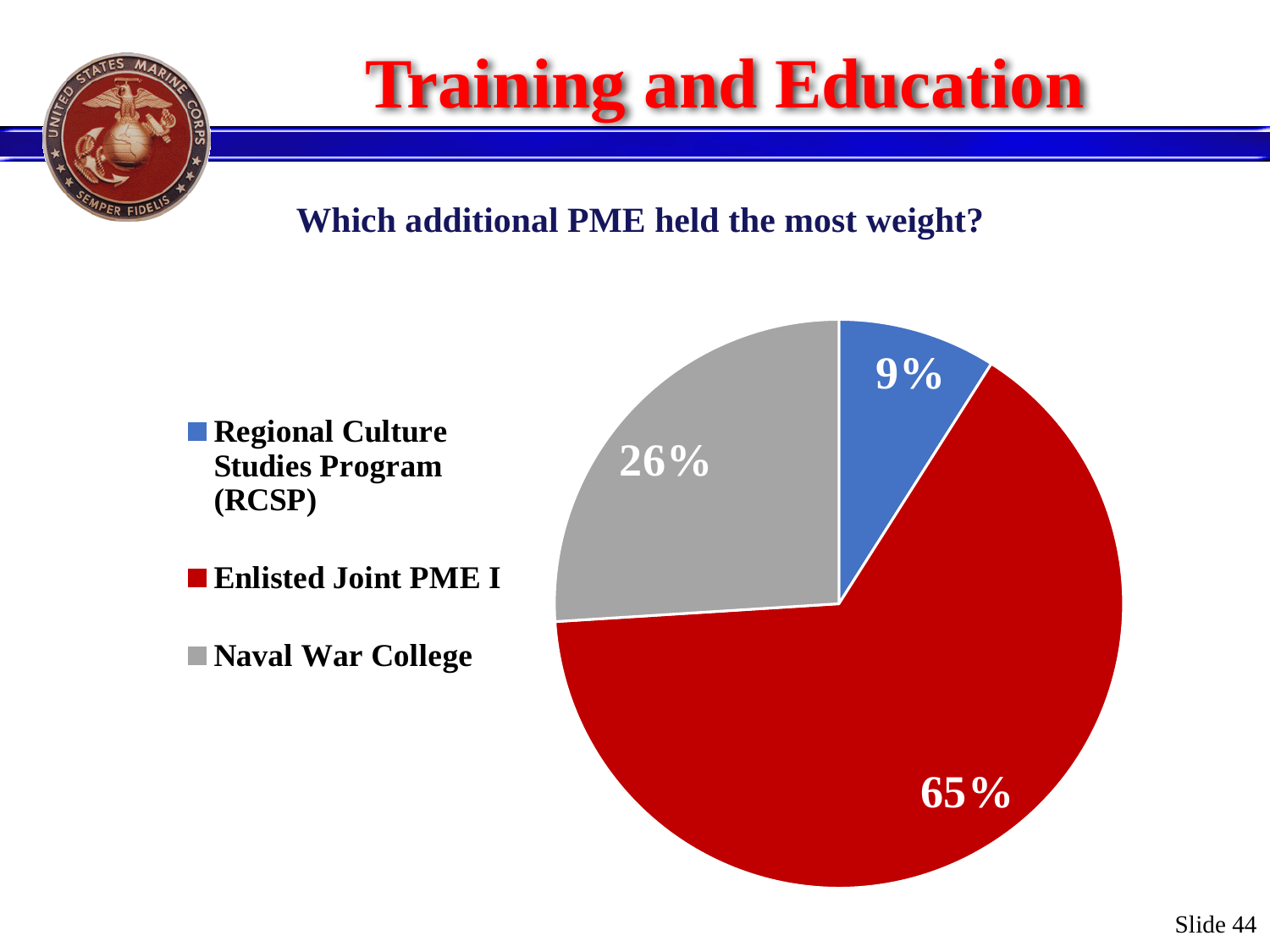
Which category has the largest slice of the pie? Enlisted Joint PME I What share of the pie does Regional Culture Studies Program (RCSP) hold? 9% What share of the pie does Enlisted Joint PME I hold? 65% Which category has the smallest slice of the pie? Regional Culture Studies Program (RCSP) What is the difference in percentage points between Naval War College and Regional Culture Studies Program (RCSP)? 17 How many entries does the legend list? 3 What colour is the slice for Enlisted Joint PME I? red How many slices does the pie chart have? 3 Which is larger, the slice for Naval War College or the slice for Regional Culture Studies Program (RCSP)? Naval War College What kind of chart is shown on the slide? pie chart What is the difference in percentage points between Enlisted Joint PME I and Naval War College? 39 What share of the pie does Naval War College hold? 26%